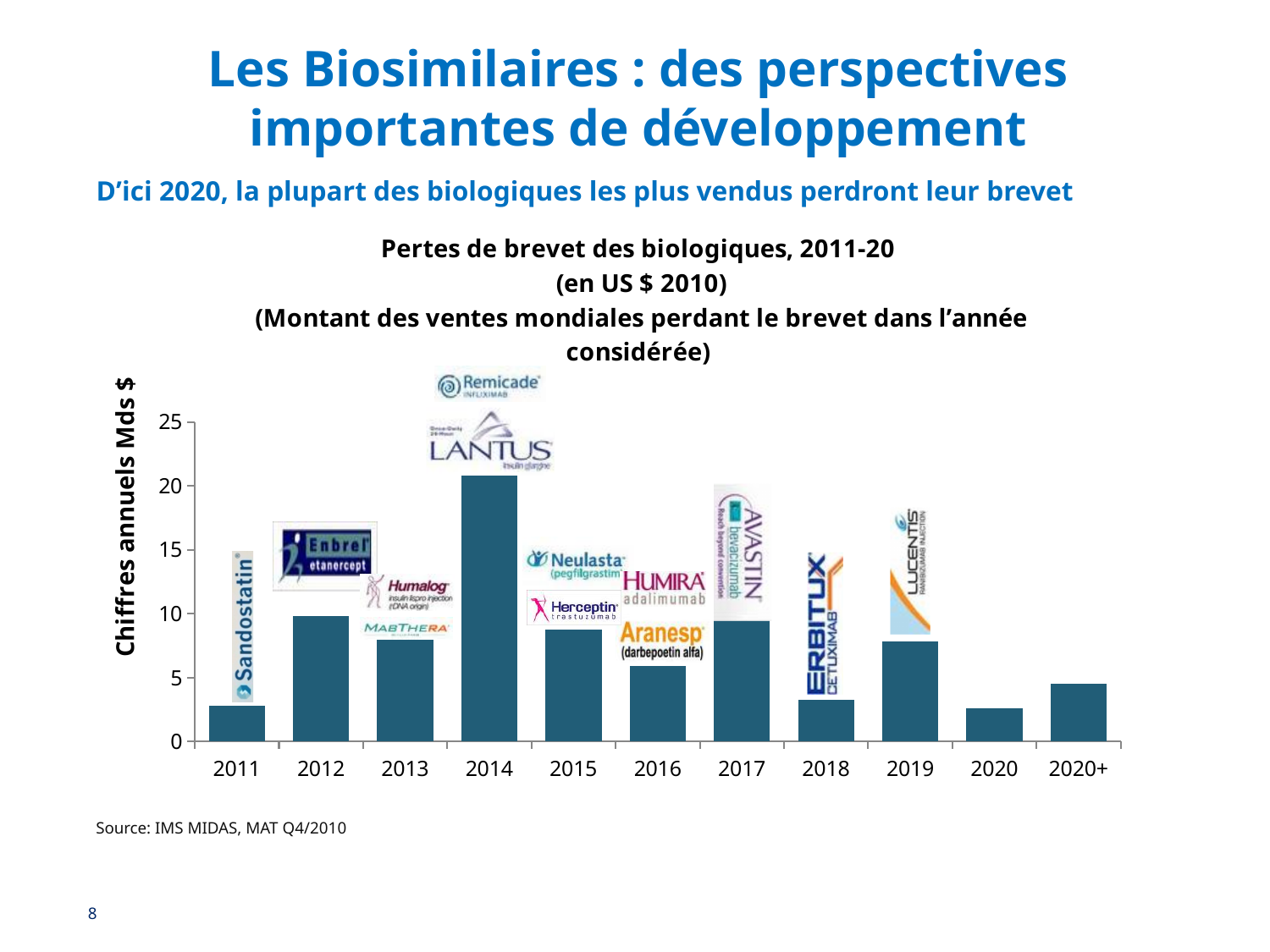
What kind of chart is shown on the slide? bar chart Is the value for 2016 greater or less than 5? greater What source is cited below the chart? IMS MIDAS, MAT Q4/2010 Which year has the larger value, 2014 or 2012? 2014 How many categories (years) are shown on the x axis of the chart? 11 Which year has the highest bar in the chart? 2014 Is the value for 2014 greater or less than 20? greater Which year has the larger value, 2016 or 2018? 2016 Is the value for 2013 greater or less than 10? less What is the label of the vertical axis of the chart? Chiffres annuels Mds $